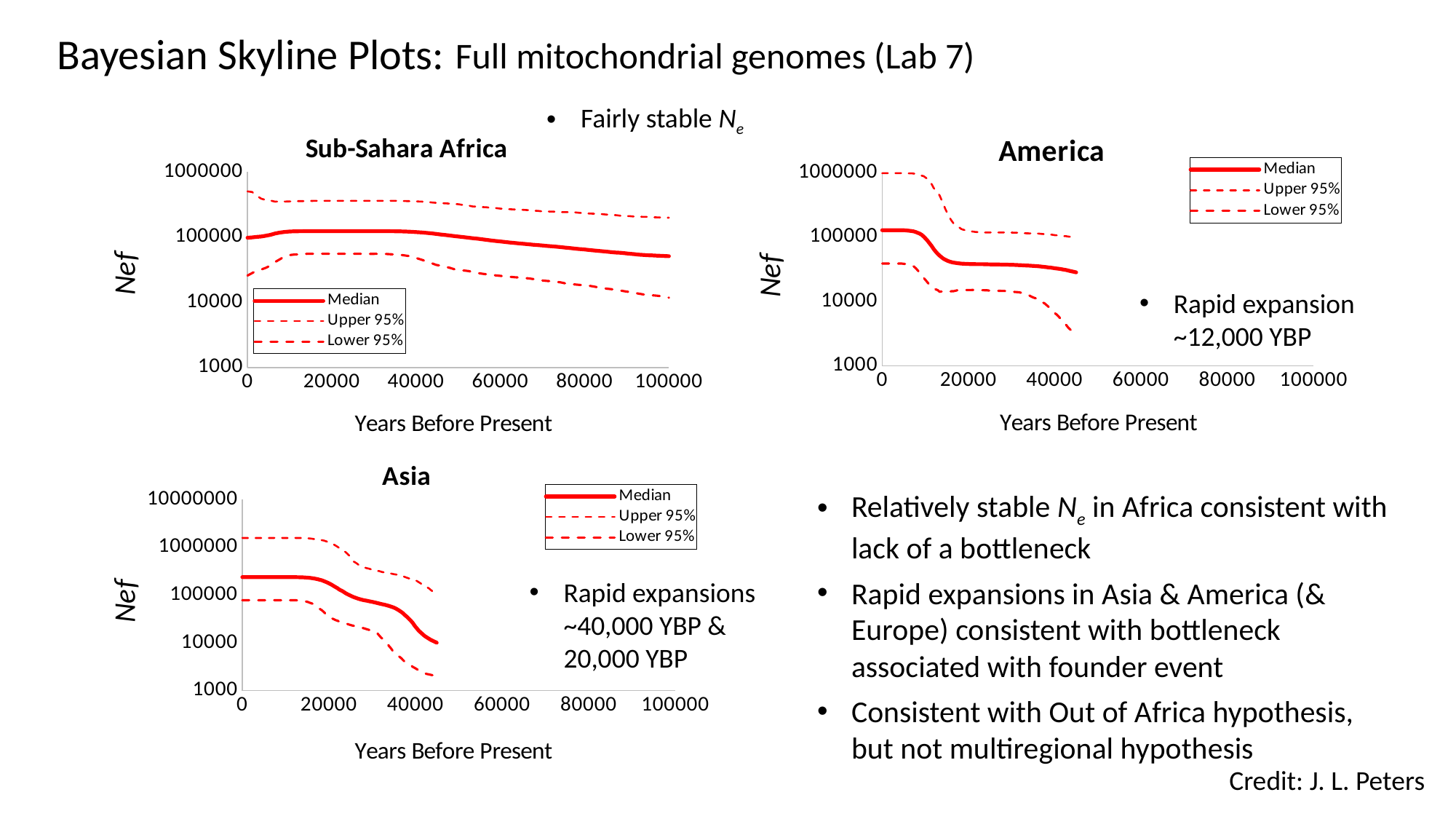
In the Asia chart, is the Median value at 0 Years Before Present greater or less than 100000? Greater How many charts are shown on the slide? 3 What kind of chart is the Sub-Sahara Africa chart? Line chart How many series does the legend of the America chart list? 3 In the America chart, is the Lower 95% value at 40000 Years Before Present greater or less than 10000? Less What is the x-axis label of the America chart? Years Before Present In the Sub-Sahara Africa chart, is the Median value at 0 Years Before Present greater or less than 10000? Greater In the Asia chart, does the Median line rise or fall as Years Before Present increases? Fall In the Sub-Sahara Africa chart, does the Median line rise or fall between 40000 and 100000 Years Before Present? Fall In the Sub-Sahara Africa chart, at 0 Years Before Present, which line is higher, Upper 95% or Lower 95%? Upper 95% In the America chart, does the Median line rise or fall as Years Before Present increases from 0 to 40000? Fall What are the legend entries in the Asia chart? Median, Upper 95%, Lower 95%